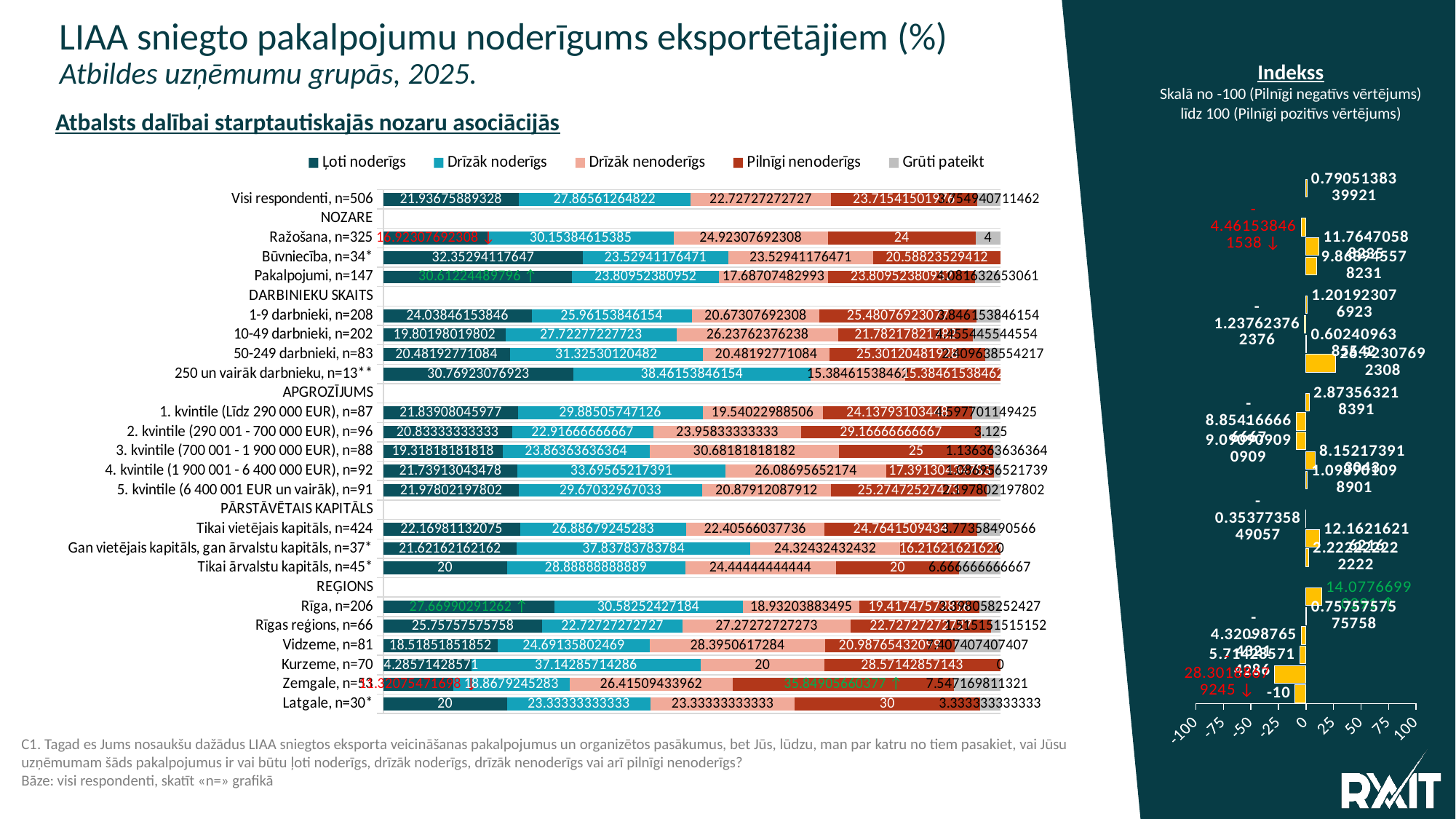
In the main chart, what is the 'Grūti pateikt' value for 'Kurzeme, n=70'? 0 In the main chart, what is the 'Ļoti noderīgs' value for 'Būvniecība, n=34*'? 32.35294117647 What kind of chart is the main chart on the left of the slide? Stacked bar chart In the main chart, is the 'Ļoti noderīgs' value larger for 'Pakalpojumi, n=147' or for 'Ražošana, n=325'? Pakalpojumi, n=147 In the main chart, what is the 'Pilnīgi nenoderīgs' value for 'Latgale, n=30*'? 30 In the main chart, which region has the highest 'Ļoti noderīgs' value among Rīga, Rīgas reģions, Vidzeme, Kurzeme, Zemgale and Latgale? Rīga, n=206 In the 'Indekss' chart on the right, what is the index value for 'Zemgale'? -28.30188679245 How many series does the legend of the main chart list? 5 In the main chart, what is the 'Drīzāk noderīgs' value for '250 un vairāk darbinieku, n=13**'? 38.46153846154 In the main chart, which region has the lowest 'Ļoti noderīgs' value among Rīga, Rīgas reģions, Vidzeme, Kurzeme, Zemgale and Latgale? Zemgale, n=53 In the main chart, what is the 'Pilnīgi nenoderīgs' value for 'Ražošana, n=325'? 24 In the main chart, what is the 'Drīzāk noderīgs' value for 'Visi respondenti, n=506'? 27.86561264822